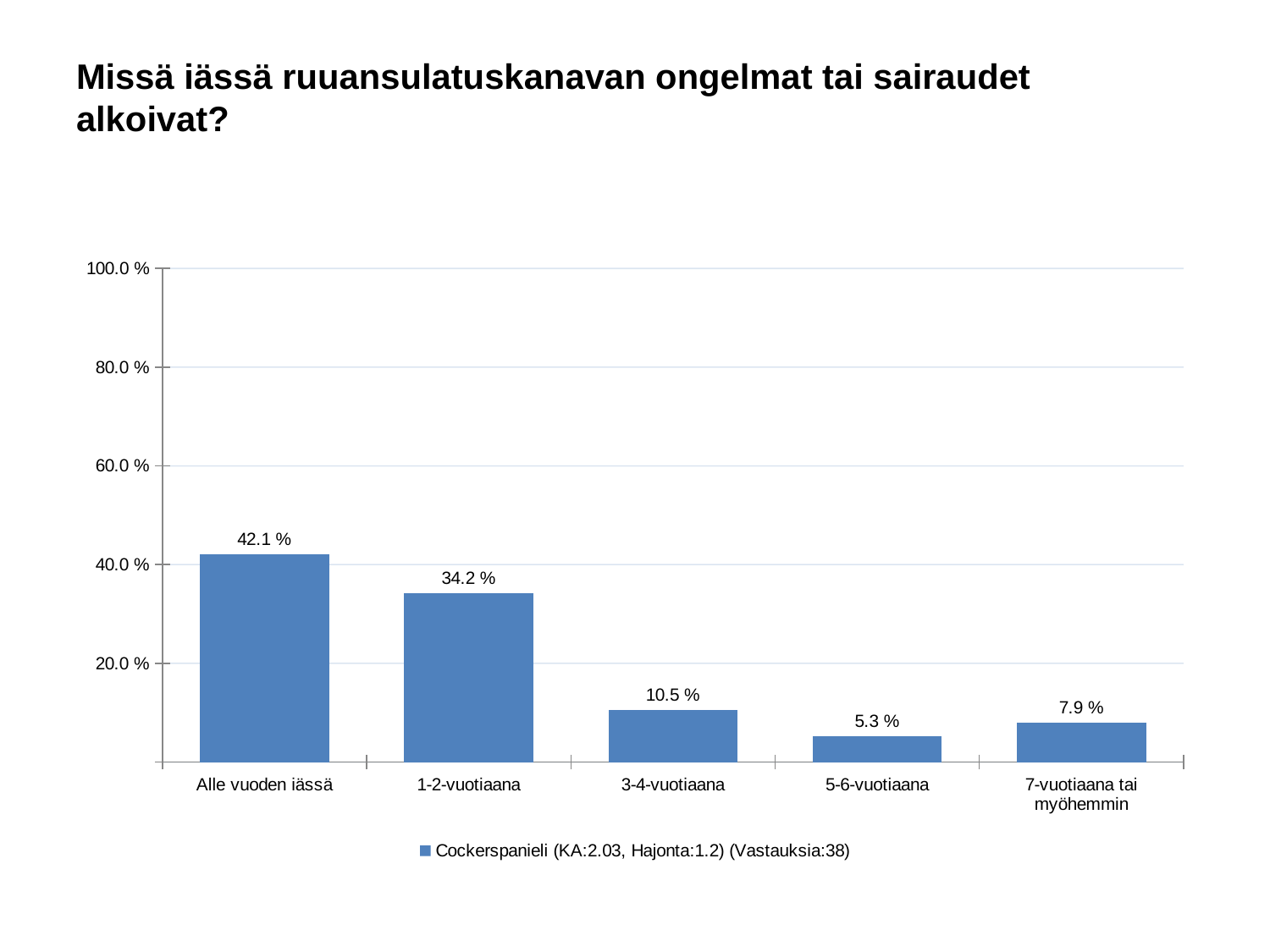
What is the value for "3-4-vuotiaana"? 10.5 % Which is larger, the value for "3-4-vuotiaana" or the value for "7-vuotiaana tai myöhemmin"? 3-4-vuotiaana What is the value for "7-vuotiaana tai myöhemmin"? 7.9 % What is the value for "Alle vuoden iässä"? 42.1 % What kind of chart is shown on the slide? bar chart How many categories are shown on the x axis? 5 What is the legend entry for the series? Cockerspanieli (KA:2.03, Hajonta:1.2) (Vastauksia:38) How many series does the legend list? 1 Which category has the lowest value? 5-6-vuotiaana What is the difference between the values for "Alle vuoden iässä" and "1-2-vuotiaana"? 7.9 % Which category has the highest value? Alle vuoden iässä Is the value for "1-2-vuotiaana" greater or less than 40.0 %? less